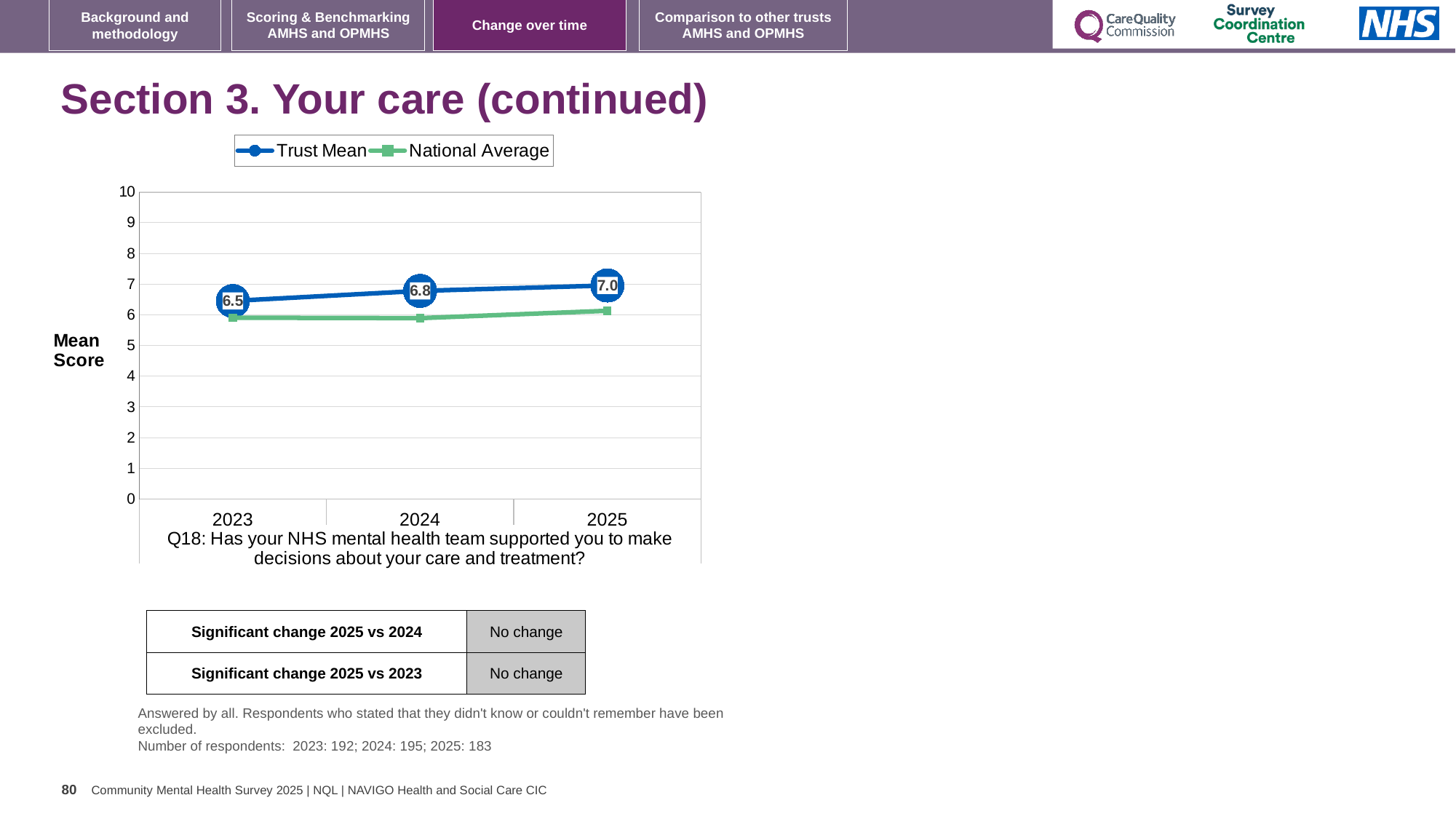
In which year is the Trust Mean highest? 2025 How many series does the legend list? 2 Does the Trust Mean rise or fall from 2023 to 2025? rise In which year is the Trust Mean lowest? 2023 What is the Trust Mean score for 2025? 7.0 What is the Trust Mean score for 2024? 6.8 What is the Trust Mean score for 2023? 6.5 What is the difference between the Trust Mean in 2025 and in 2023? 0.5 How many years are shown on the x axis? 3 Is the National Average value for 2023 greater or less than 7? less What kind of chart is shown on the slide? line chart Which is larger, the Trust Mean in 2024 or in 2023? 2024